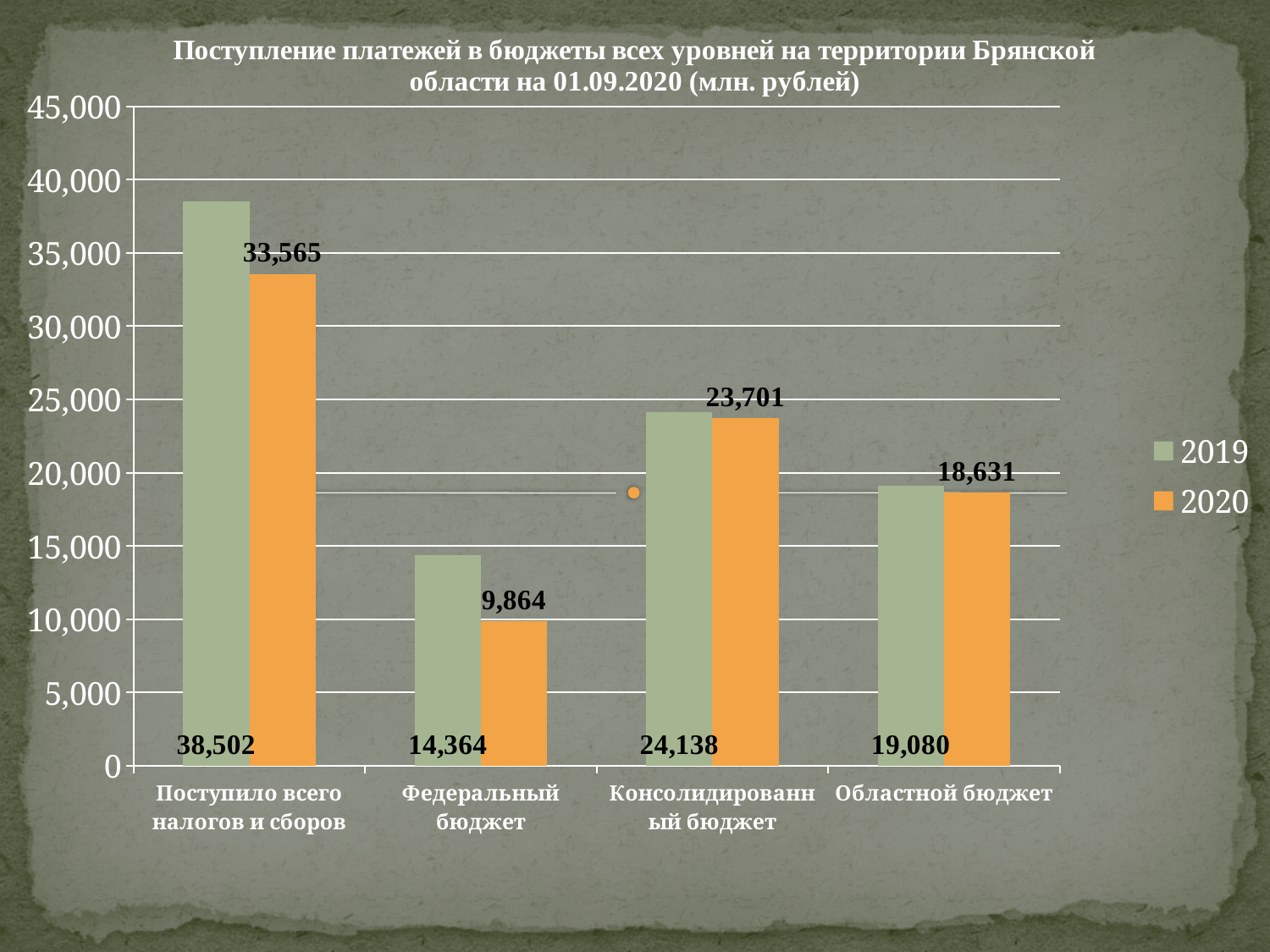
What is the 2019 value for Поступило всего налогов и сборов? 38,502 What is the difference between the 2019 and 2020 values for Поступило всего налогов и сборов? 4,937 What is the 2019 value for Областной бюджет? 19,080 What is the difference between the 2019 and 2020 values for Федеральный бюджет? 4,500 Which category has the lowest 2020 value? Федеральный бюджет Which is larger for Областной бюджет: the 2019 value or the 2020 value? 2019 What is the 2020 value for Федеральный бюджет? 9,864 What kind of chart is shown on the slide? Bar chart What is the 2020 value for Консолидированный бюджет? 23,701 How many categories are shown on the x axis? 4 Which category has the highest 2019 value? Поступило всего налогов и сборов How many series does the legend list? 2